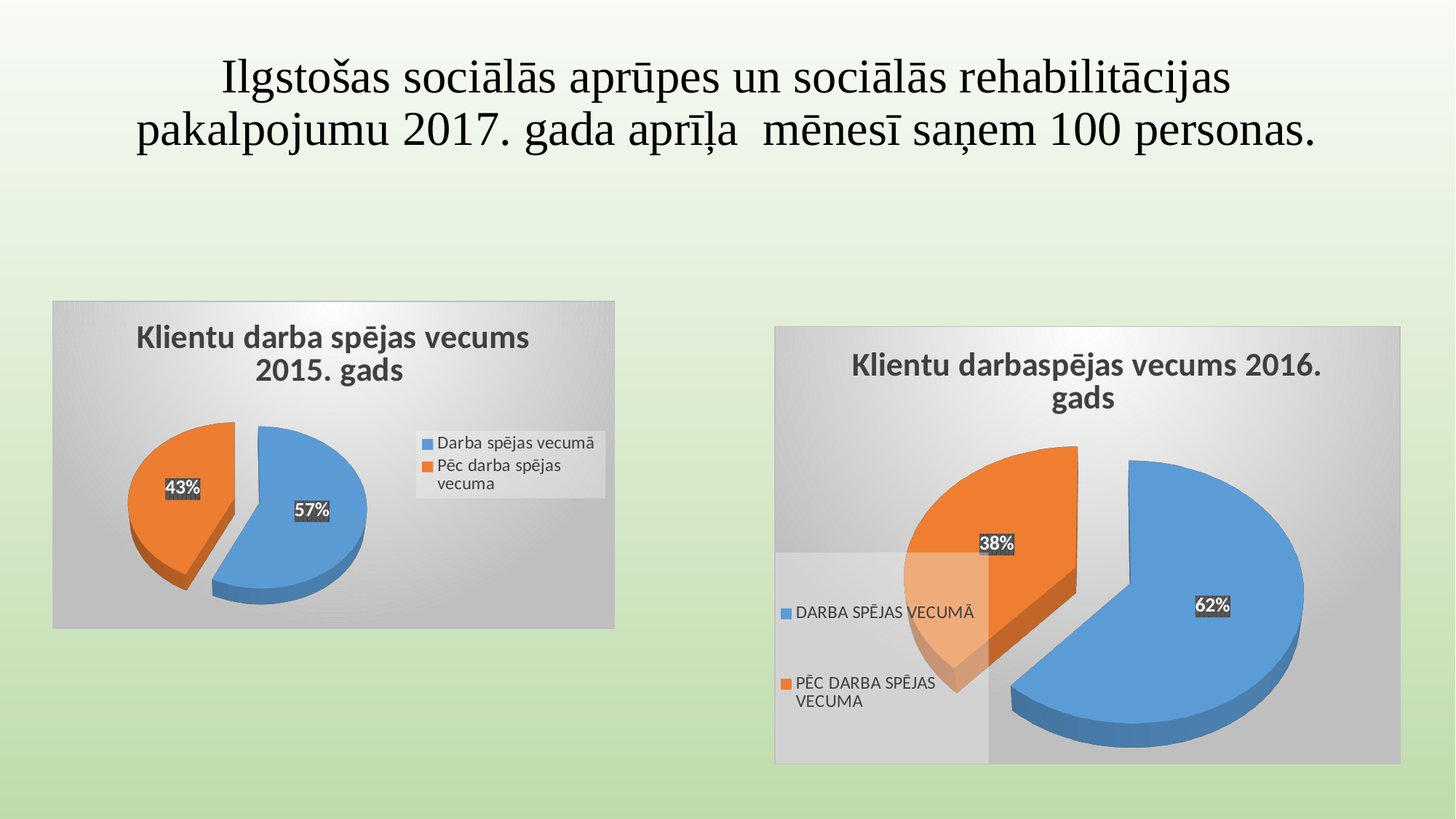
In the chart titled "Klientu darba spējas vecums 2015. gads", what share is labelled for "Pēc darba spējas vecuma"? 43% In the chart titled "Klientu darba spējas vecums 2015. gads", what share is labelled for "Darba spējas vecumā"? 57% In the chart titled "Klientu darba spējas vecums 2015. gads", which category has the largest slice? Darba spējas vecumā In the chart titled "Klientu darbaspējas vecums 2016. gads", what share is labelled for "PĒC DARBA SPĒJAS VECUMA"? 38% In the chart titled "Klientu darbaspējas vecums 2016. gads", which category has the smallest slice? PĒC DARBA SPĒJAS VECUMA What type of chart is the chart titled "Klientu darba spējas vecums 2015. gads"? Pie chart In the chart titled "Klientu darba spējas vecums 2015. gads", what colour is the "Pēc darba spējas vecuma" slice? Orange In the chart titled "Klientu darba spējas vecums 2015. gads", what is the difference in percentage points between the two slices? 14 In the chart titled "Klientu darbaspējas vecums 2016. gads", what is the difference in percentage points between the two slices? 24 How many categories does the chart titled "Klientu darbaspējas vecums 2016. gads" show? 2 Which is larger: the "Darba spējas vecumā" share in the 2015 chart or the "DARBA SPĒJAS VECUMĀ" share in the 2016 chart? 2016 chart (62%) In the chart titled "Klientu darbaspējas vecums 2016. gads", what share is labelled for "DARBA SPĒJAS VECUMĀ"? 62%